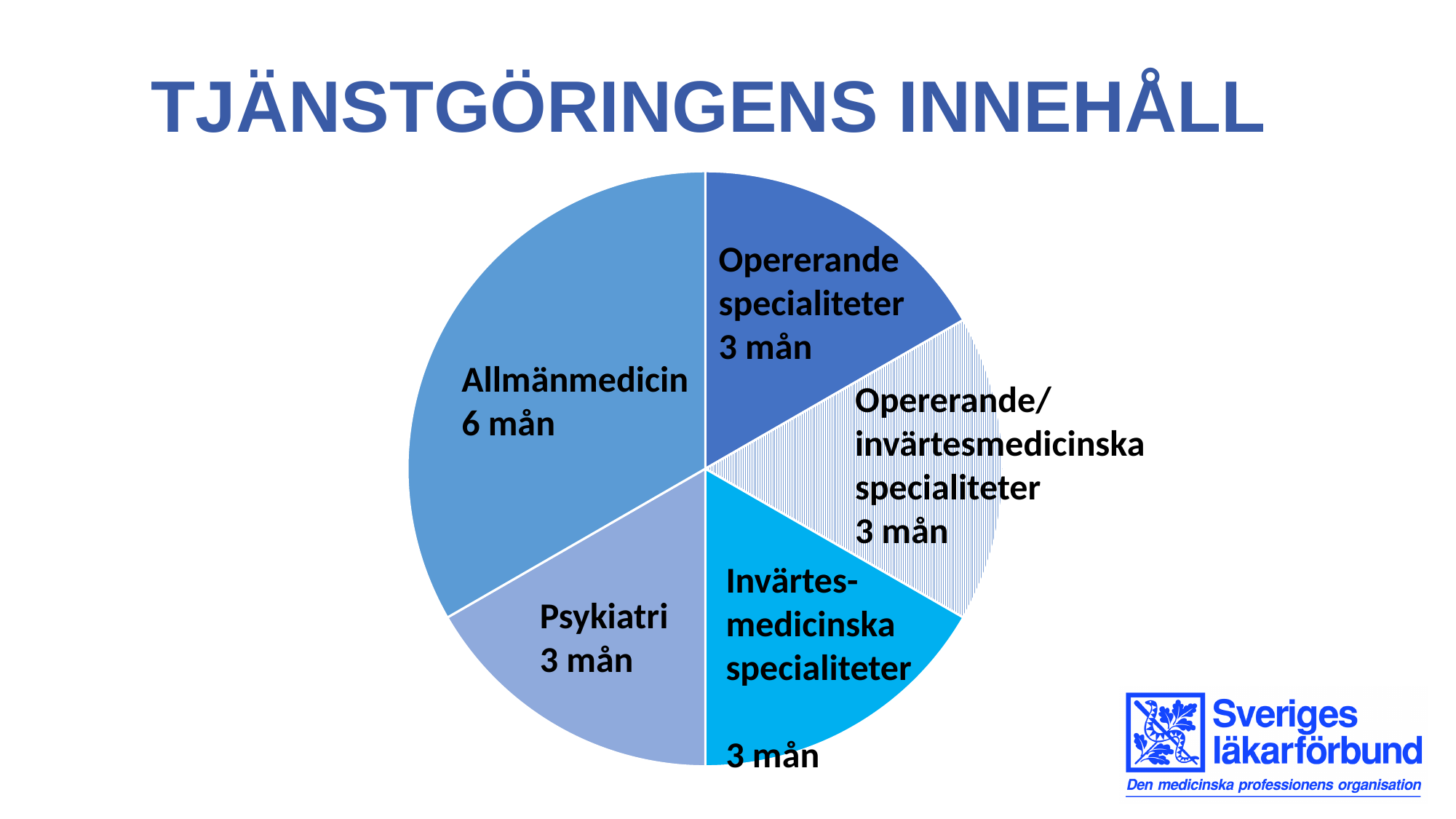
What is the total number of months across all slices of the pie chart? 18 mån How many months are shown for Opererande specialiteter? 3 mån Which slice of the pie chart is the largest? Allmänmedicin How many months are shown for Invärtesmedicinska specialiteter? 3 mån What is the difference in months between Allmänmedicin and Psykiatri? 3 mån What kind of chart is shown on the slide? Pie chart What is the title of the slide containing the pie chart? TJÄNSTGÖRINGENS INNEHÅLL Which slice of the pie chart is drawn with a striped pattern? Opererande/invärtesmedicinska specialiteter How many months are shown for Allmänmedicin? 6 mån How many months are shown for Psykiatri? 3 mån Which is larger, the slice for Allmänmedicin or the slice for Opererande specialiteter? Allmänmedicin How many slices does the pie chart have? 5